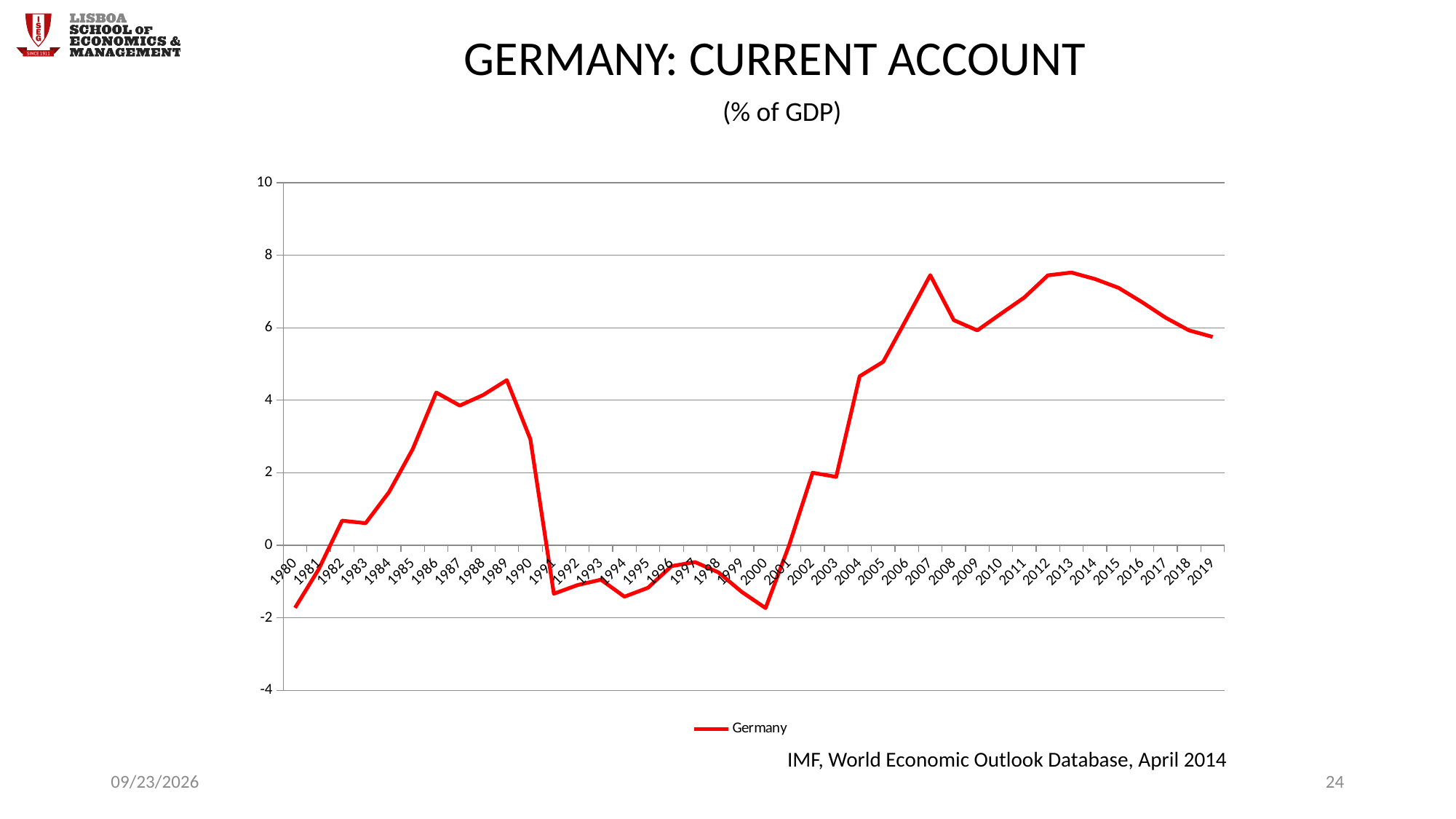
How many series does the legend list? 1 Is the value for 2007 greater or less than 6? greater Is the value for 2019 greater or less than 6? less How many years are plotted along the x axis? 40 Which year has the larger value, 2004 or 1990? 2004 Which year has the larger value, 1989 or 1986? 1989 Is the value for 1989 greater or less than 4? greater Do the values rise or fall from 2013 to 2019? fall What is the title of the chart? GERMANY: CURRENT ACCOUNT What kind of chart is shown on the slide? line chart